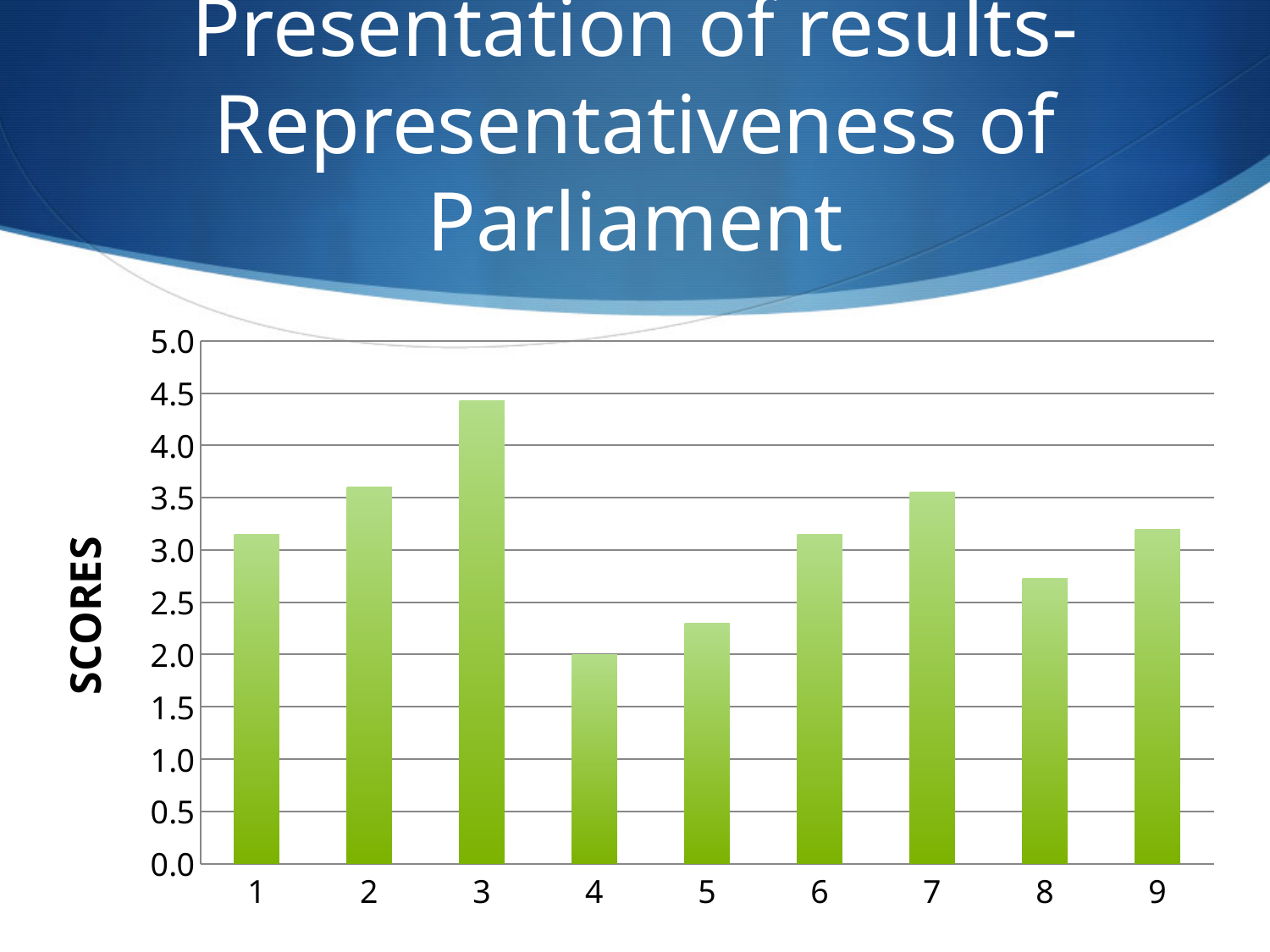
Is the score for category 2 greater or less than 3.5? greater What kind of chart is shown on the slide? bar chart Which category has the lowest score in the chart? 4 Is the score for category 5 greater or less than 2.5? less Is the score for category 8 greater or less than 3.0? less Which has a higher score, category 2 or category 5? 2 Which has a higher score, category 8 or category 7? 7 What is the highest value shown on the vertical axis of the chart? 5.0 How many categories are shown on the x axis of the chart? 9 Which category has the highest score in the chart? 3 What is the label of the vertical axis of the chart? SCORES